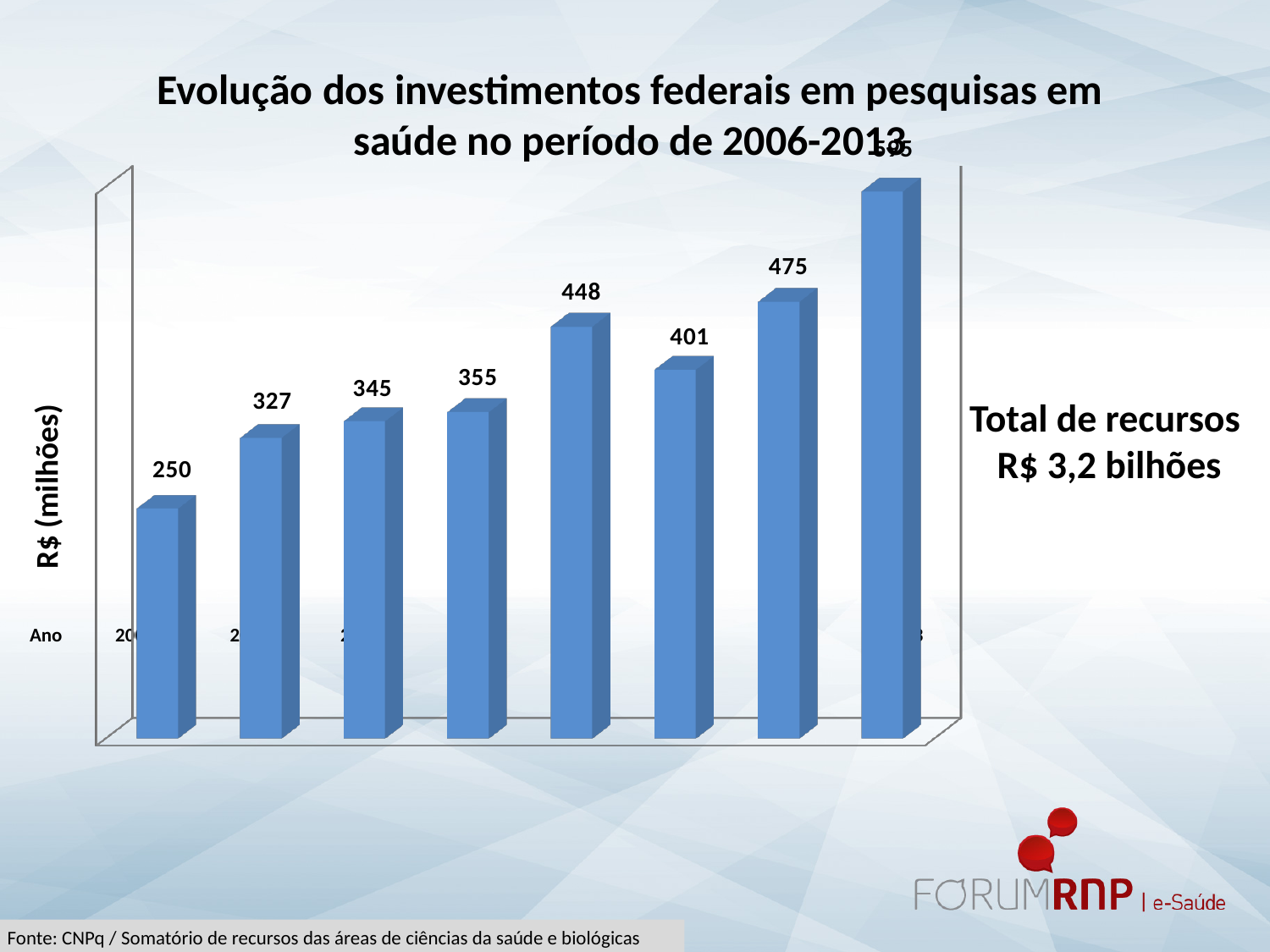
How many bars does the chart contain? 8 Which is larger, the fifth bar or the sixth bar? the fifth bar (448) What is the difference between the fourth bar (355) and the third bar (345)? 10 What is the difference between the seventh bar (475) and the first bar (250)? 225 What is the value shown on the fifth bar from the left? 448 What is the value shown on the first (leftmost) bar? 250 What is the value shown on the second bar from the left? 327 What total amount of resources is stated next to the chart? R$ 3,2 bilhões What is the value shown on the seventh bar from the left? 475 What kind of chart is shown on the slide? bar chart What is the label of the vertical axis? R$ (milhões) Which bar has the lowest value? the first (leftmost) bar, 250